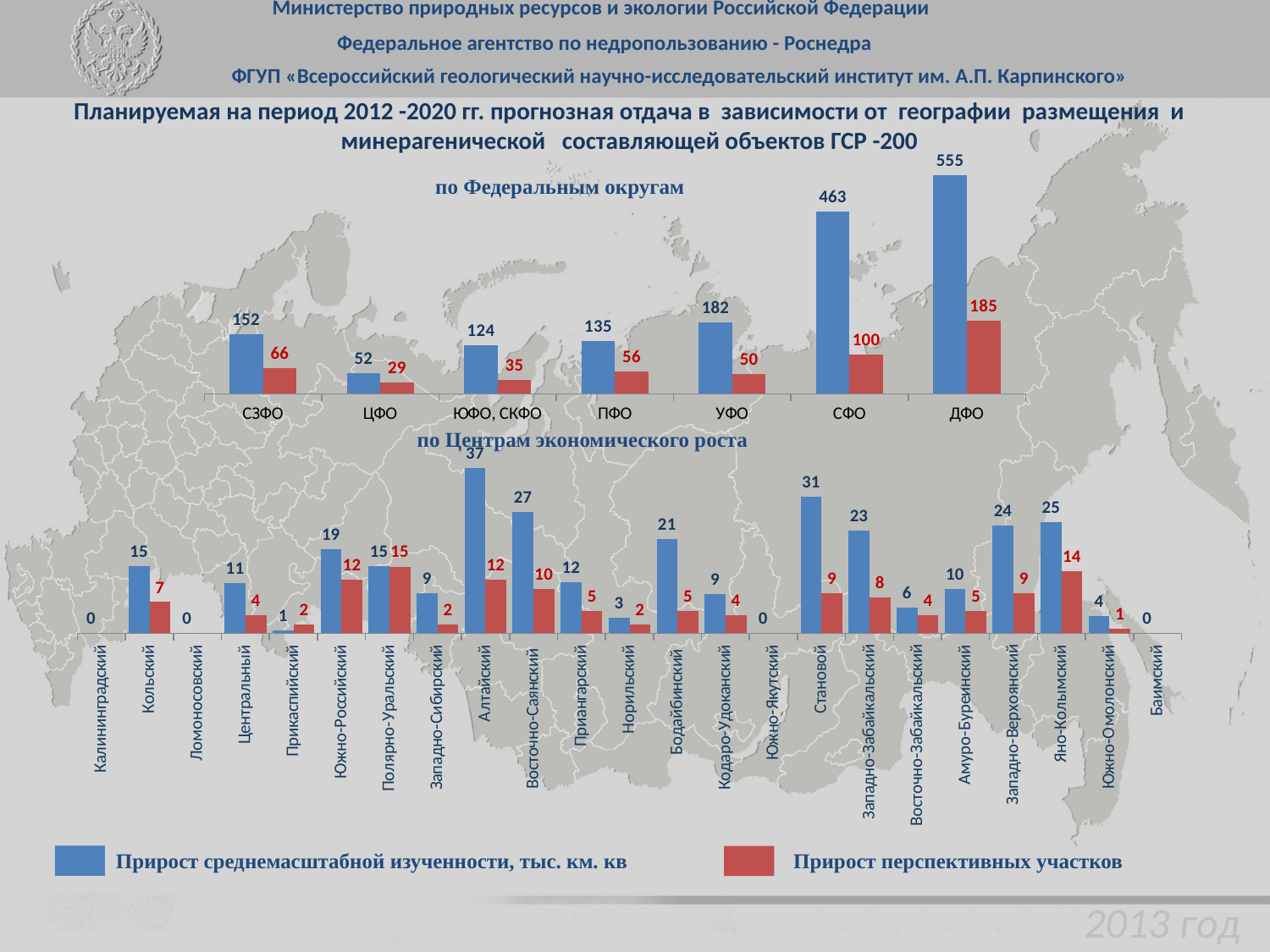
In the chart 'по Центрам экономического роста', what is the value of Прирост перспективных участков for Яно-Колымский? 14 In the chart 'по Федеральным округам', what is the value of Прирост перспективных участков for СФО? 100 In the chart 'по Федеральным округам', how many federal districts are shown on the x axis? 7 In the chart 'по Центрам экономического роста', which is larger: the Прирост среднемасштабной изученности value for Становой or for Западно-Забайкальский? Становой In the chart 'по Федеральным округам', which federal district has the lowest value of Прирост среднемасштабной изученности? ЦФО In the chart 'по Федеральным округам', what is the difference between the Прирост среднемасштабной изученности values for ДФО and СФО? 92 What type of chart is 'по Федеральным округам'? Bar chart How many series does the legend at the bottom of the slide list? 2 In the chart 'по Центрам экономического роста', which centre has the highest value of Прирост среднемасштабной изученности? Алтайский In the chart 'по Центрам экономического роста', what is the difference between the Прирост среднемасштабной изученности values for Восточно-Саянский and Бодайбинский? 6 In the chart 'по Федеральным округам', what is the value of Прирост среднемасштабной изученности for ДФО? 555 In the chart 'по Центрам экономического роста', what is the value of Прирост среднемасштабной изученности for Алтайский? 37